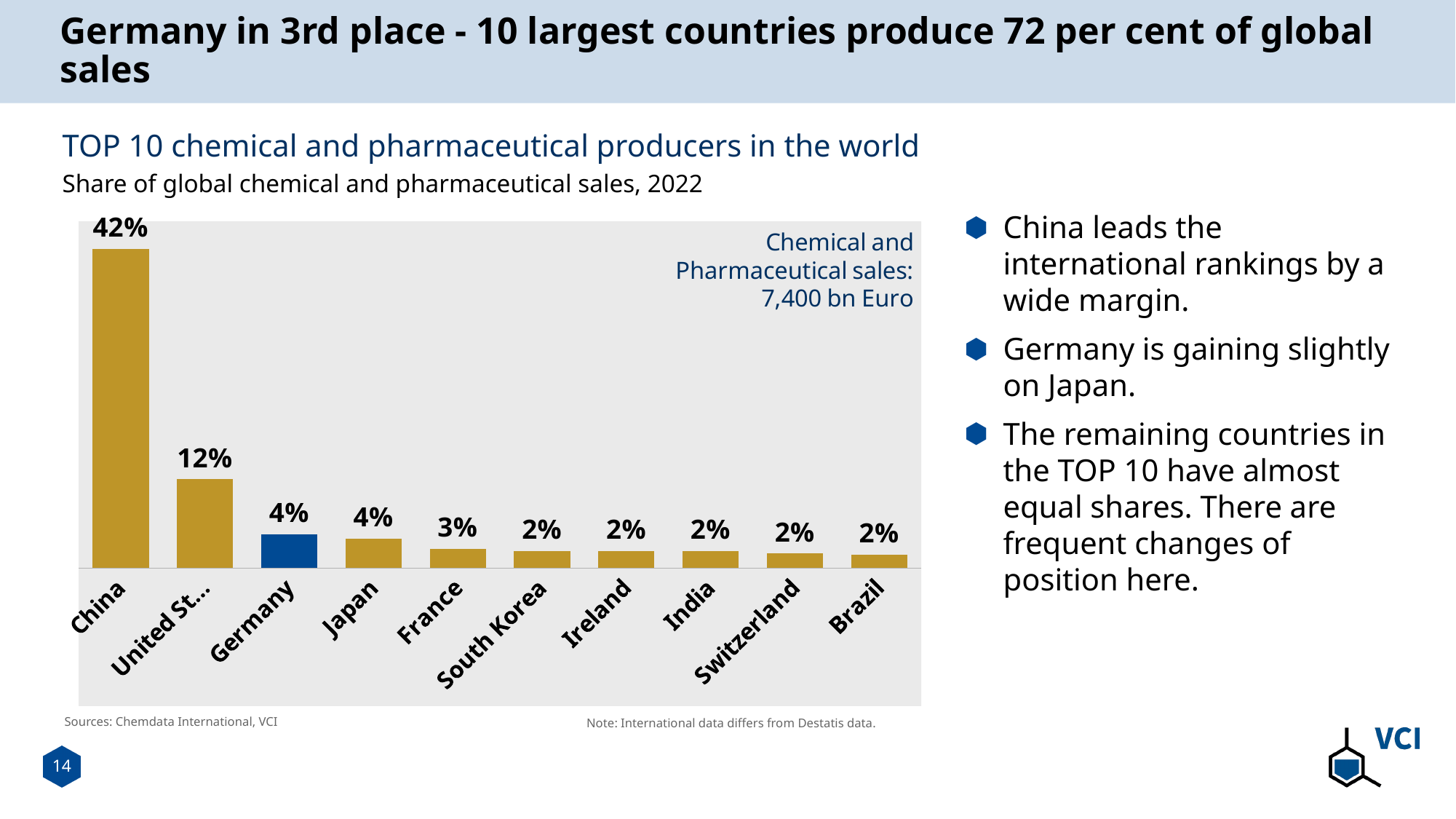
Do the shares rise or fall from left to right across the countries? Fall How many countries are shown in the chart? 10 What is the difference in share between China and the United States? 30% Which has a larger share of global sales, the United States or Japan? United States What kind of chart is used to show the shares of global chemical and pharmaceutical sales? Bar chart What share of global chemical and pharmaceutical sales does China have? 42% What share of global chemical and pharmaceutical sales does Germany have? 4% Which country's bar is coloured blue instead of gold? Germany What share of global chemical and pharmaceutical sales does France have? 3% Which country has the highest share of global chemical and pharmaceutical sales? China What is the total value of chemical and pharmaceutical sales stated in the chart? 7,400 bn Euro What is the difference in share between Germany and France? 1%